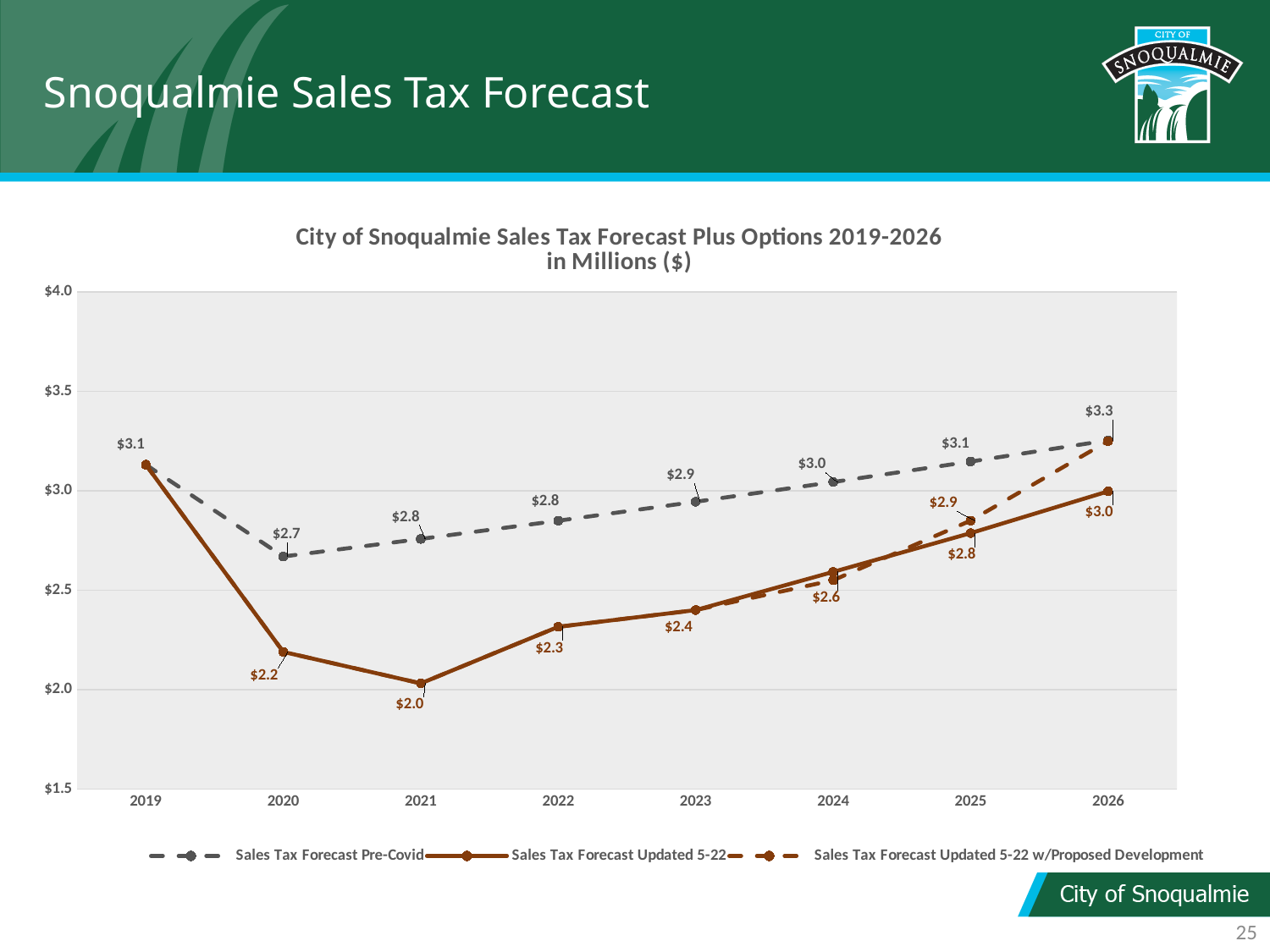
In 2023, which is larger: the Sales Tax Forecast Pre-Covid value or the Sales Tax Forecast Updated 5-22 value? Sales Tax Forecast Pre-Covid What is the Sales Tax Forecast Updated 5-22 w/Proposed Development value for 2025? $2.9 In which year is the Sales Tax Forecast Pre-Covid series at its highest? 2026 How many series does the legend list? 3 What is the Sales Tax Forecast Updated 5-22 value for 2021? $2.0 What is the Sales Tax Forecast Pre-Covid value for 2020? $2.7 How many years are plotted along the x axis? 8 What is the difference between the Sales Tax Forecast Pre-Covid and the Sales Tax Forecast Updated 5-22 values in 2026? $0.3 Does the Sales Tax Forecast Updated 5-22 series rise or fall from 2021 to 2026? rise In which year is the Sales Tax Forecast Updated 5-22 series at its lowest? 2021 Is the Sales Tax Forecast Updated 5-22 value for 2020 greater or less than $2.5? less What kind of chart is shown on the slide? line chart